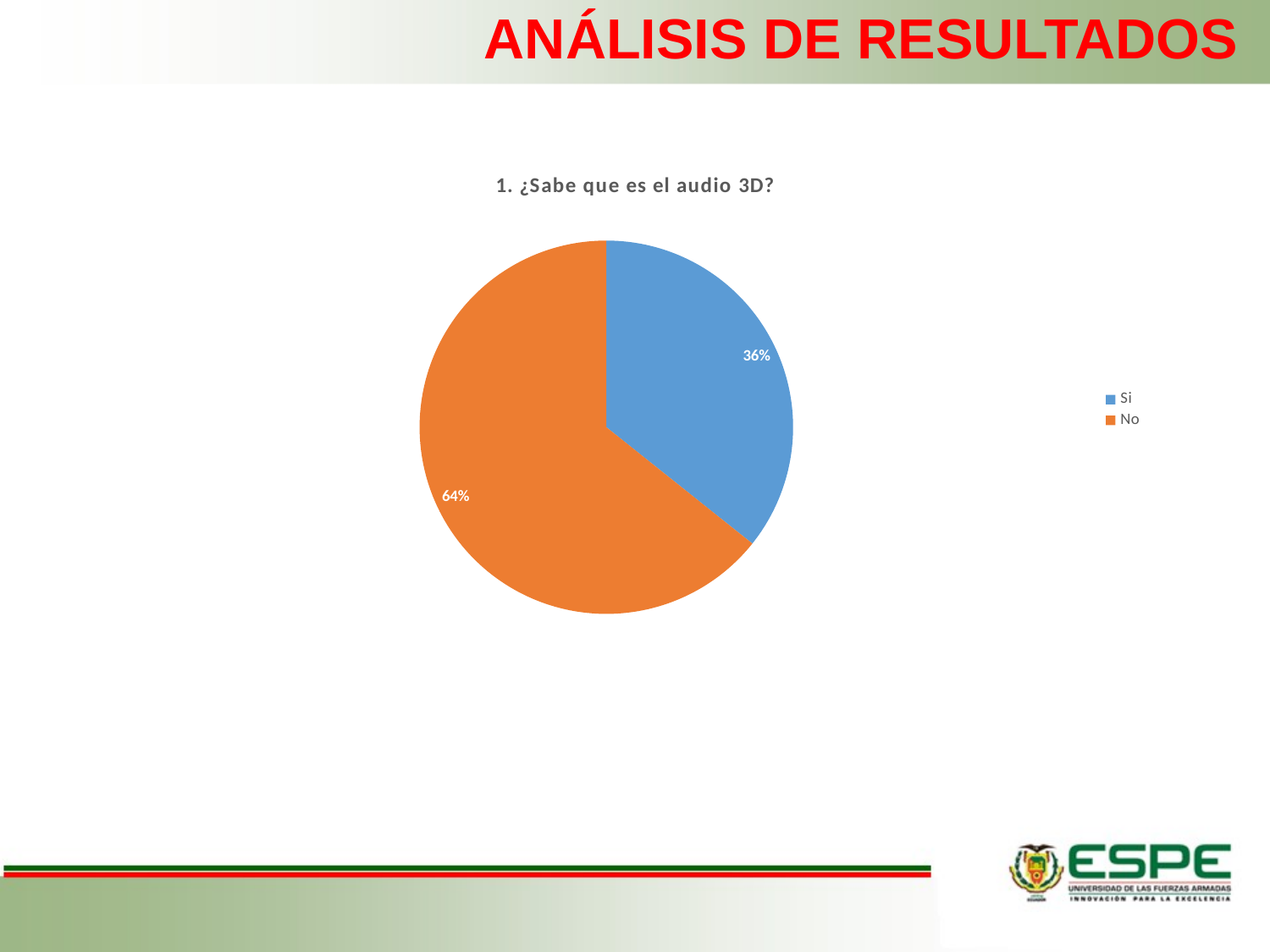
What is the difference in percentage points between the "No" slice and the "Si" slice? 28 Which slice is the smallest? Si What colour is the "No" slice? orange Which slice is the largest? No What percentage of the pie is labelled "Si"? 36% How many entries does the legend list? 2 What percentage of the pie is labelled "No"? 64% What share of the pie does the "Si" slice represent? 36% What is the chart's title? 1. ¿Sabe que es el audio 3D? Which is larger, the "Si" slice or the "No" slice? No How many slices does the pie chart have? 2 What kind of chart is shown on the slide? pie chart